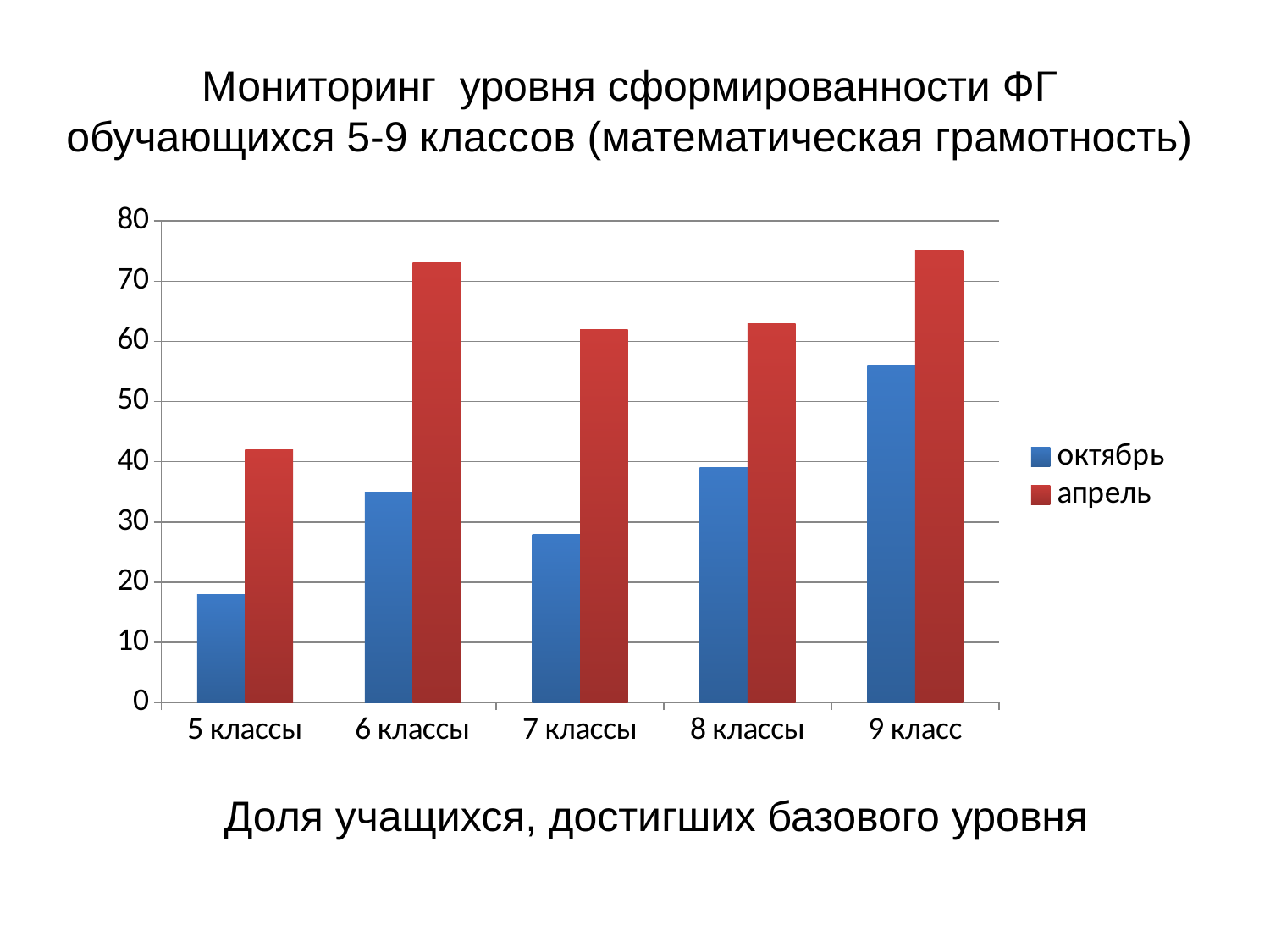
What kind of chart is shown on the slide? bar chart For 6 классы, which is larger: октябрь or апрель? апрель Which series is shown in red in the legend? апрель Which class group has the lowest value for апрель? 5 классы Is the value for апрель in 6 классы greater or less than 70? greater Is the value for октябрь in 9 класс greater or less than 50? greater How many class groups are shown on the x axis? 5 Which class group has the lowest value for октябрь? 5 классы Is the value for апрель in 7 классы greater or less than 70? less Which class group has the highest value for октябрь? 9 класс How many series does the legend list? 2